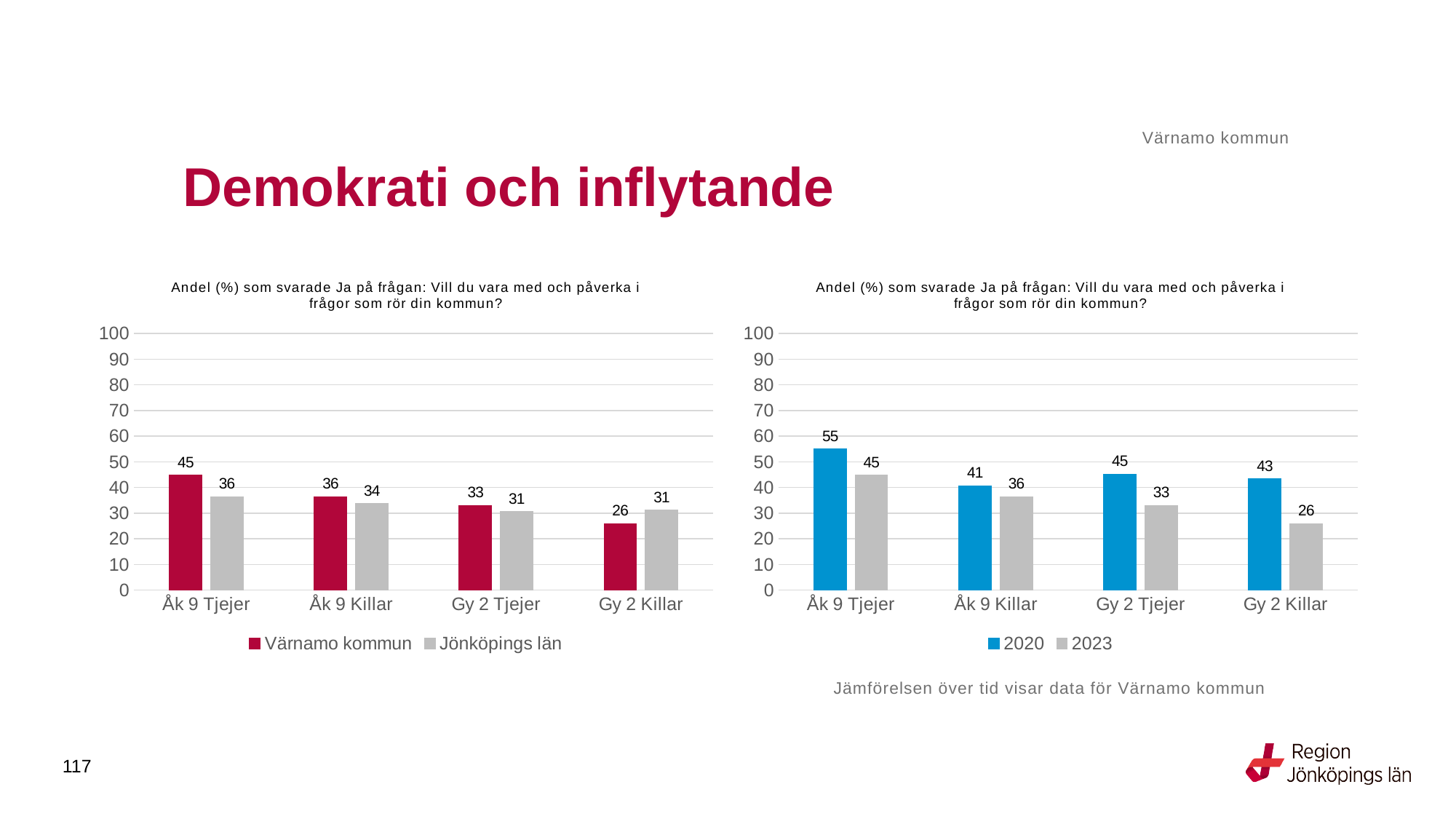
In the left chart, which is larger for Gy 2 Killar: Värnamo kommun or Jönköpings län? Jönköpings län What type of chart is the right chart? Bar chart In the left chart, what is the difference between Värnamo kommun and Jönköpings län for Åk 9 Tjejer? 9 In the left chart, what is the value for Jönköpings län for Gy 2 Killar? 31 In the right chart, what is the value for 2020 for Åk 9 Tjejer? 55 In the left chart, which category has the lowest value for Värnamo kommun? Gy 2 Killar In the right chart, what is the value for 2023 for Gy 2 Tjejer? 33 How many categories are shown on the x axis of the right chart? 4 How many series does the legend of the left chart list? 2 In the right chart, which category has the highest value for 2020? Åk 9 Tjejer In the left chart, what is the value for Värnamo kommun for Åk 9 Tjejer? 45 In the right chart, what is the difference between 2020 and 2023 for Gy 2 Killar? 17